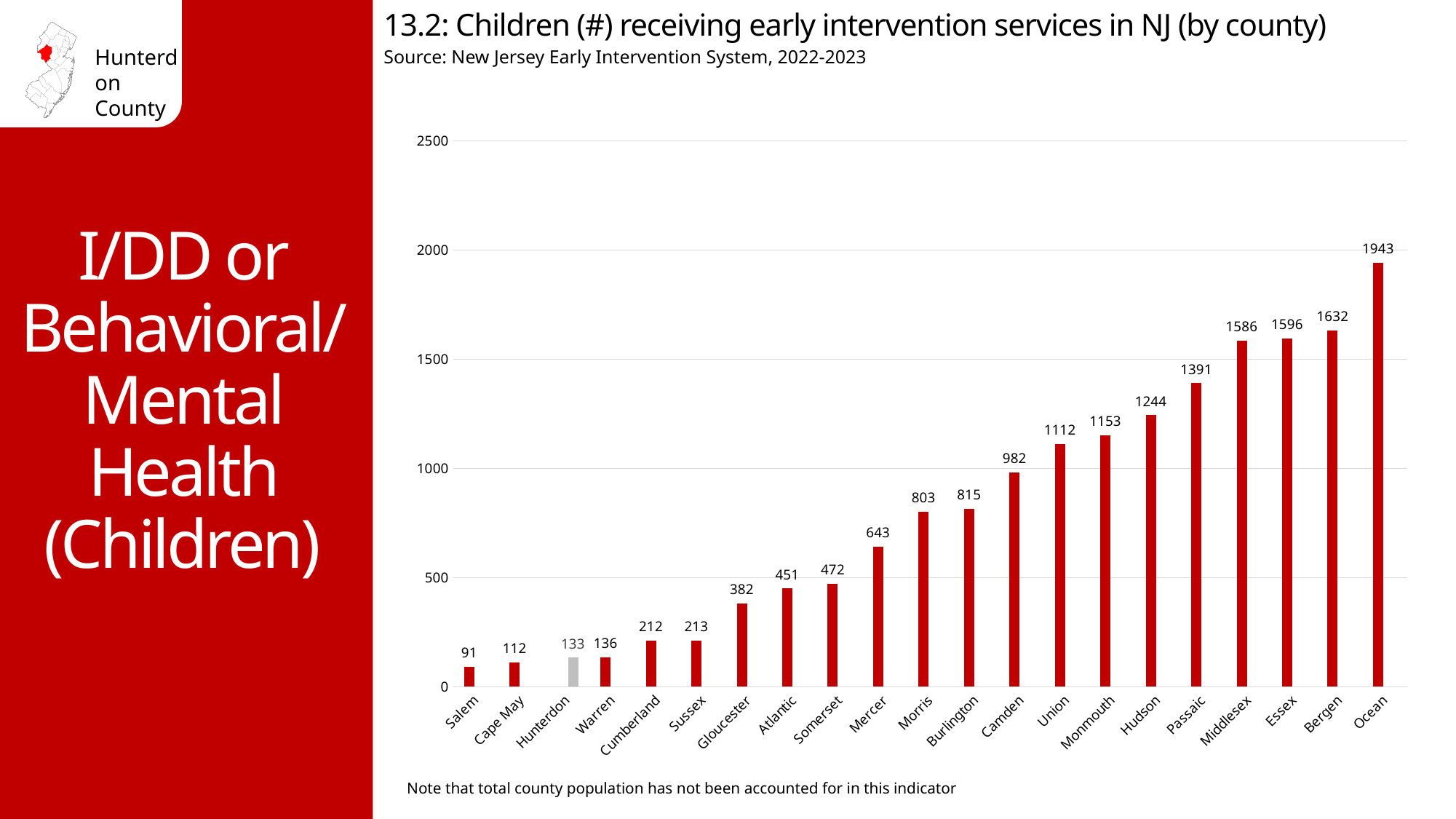
Which county's bar is coloured grey instead of red? Hunterdon What is the difference between the values for Bergen and Essex? 36 What is the value shown for Mercer County? 643 What kind of chart is shown on the slide? bar chart How many counties are shown on the chart? 21 Which county has the lowest number of children receiving early intervention services? Salem Do the values rise or fall from left to right along the x axis? rise Which county has the highest number of children receiving early intervention services? Ocean Is the value for Passaic greater or less than 1500? less Which county has a larger value, Camden or Union? Union What is the value shown for Ocean County? 1943 How many children are receiving early intervention services in Hunterdon County? 133